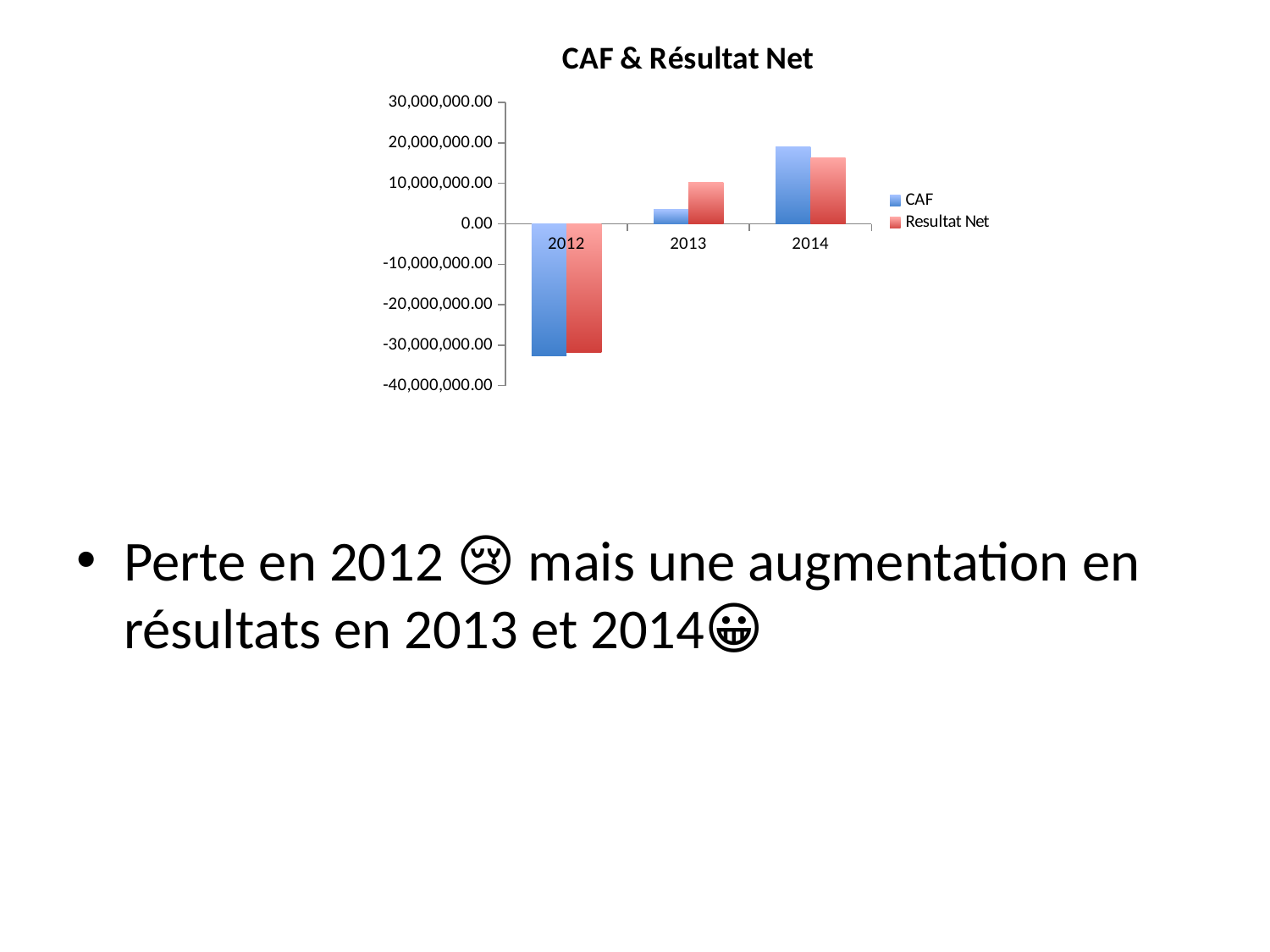
In 2014, which is larger: CAF or Resultat Net? CAF Which colour represents the Resultat Net series in the legend? Red Does the CAF value rise or fall from 2012 to 2014? rise Is the Resultat Net value for 2014 greater or less than 10,000,000.00? greater In which year is the Resultat Net value lowest? 2012 In 2013, which is larger: CAF or Resultat Net? Resultat Net How many years are shown on the x axis of the chart? 3 Is the CAF value for 2012 greater or less than -30,000,000.00? less What kind of chart is shown on the slide? Bar chart In which year is the CAF value highest? 2014 What is the title of the chart? CAF & Résultat Net How many series does the legend list? 2